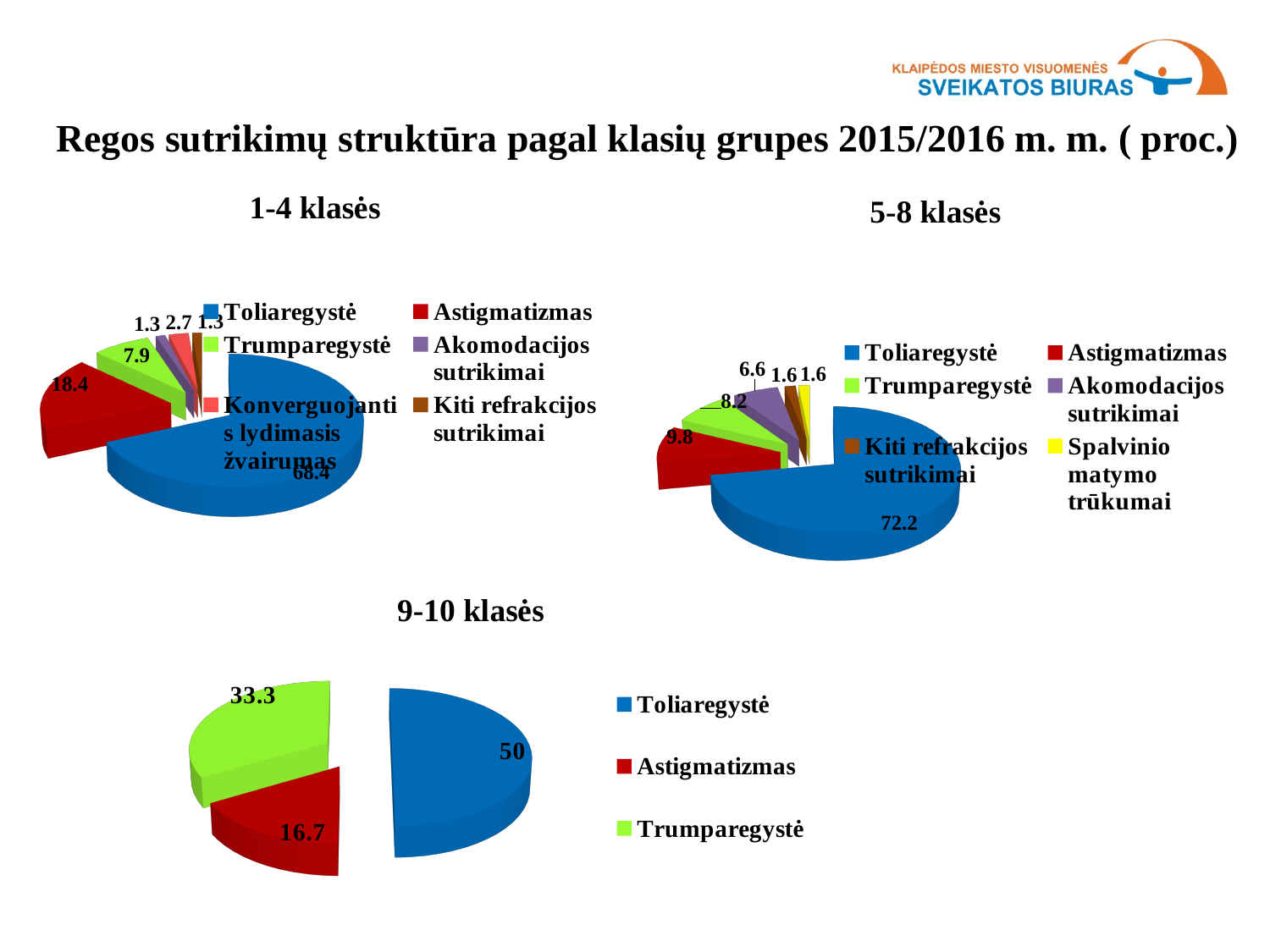
In the 5-8 klasės pie chart, which category has the largest slice? Toliaregystė In the 1-4 klasės pie chart, what is the value for Toliaregystė? 68.4 In the 1-4 klasės pie chart, which is larger: Astigmatizmas or Trumparegystė? Astigmatizmas In the 5-8 klasės pie chart, what is the value for Akomodacijos sutrikimai? 6.6 In the 1-4 klasės pie chart, what is the value for Astigmatizmas? 18.4 In the 9-10 klasės pie chart, what is the value for Trumparegystė? 33.3 In the 9-10 klasės pie chart, how many categories does the legend list? 3 What type of chart is used for the 9-10 klasės data? Pie chart In the 5-8 klasės pie chart, what is the value for Toliaregystė? 72.2 In the 9-10 klasės pie chart, which category has the smallest slice? Astigmatizmas In the 5-8 klasės pie chart, what is the difference between Astigmatizmas and Trumparegystė? 1.6 In the 1-4 klasės pie chart, what is the value for Trumparegystė? 7.9